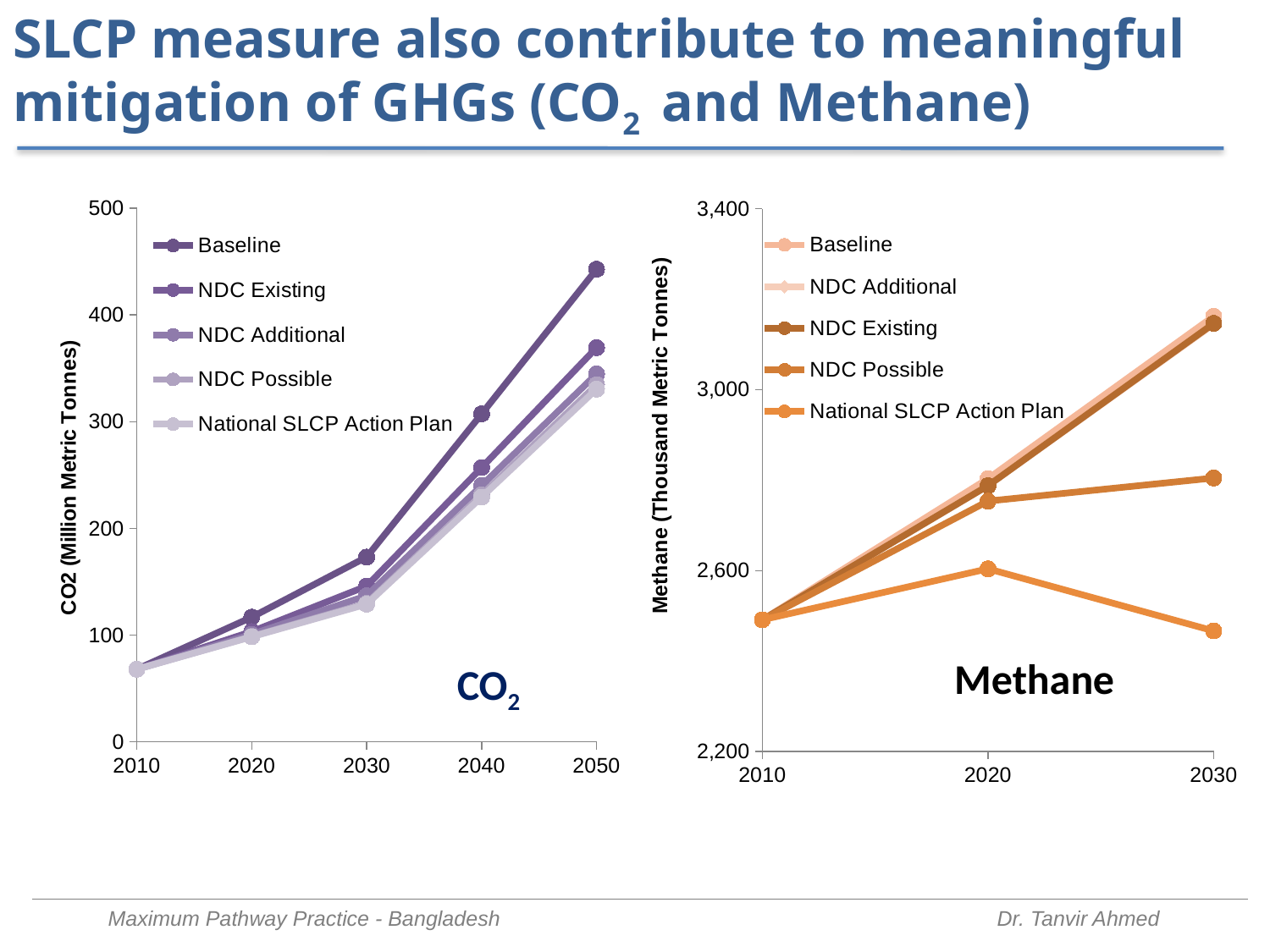
How many years are shown on the x axis of the Methane chart? 3 In the Methane chart, is the Baseline value in 2030 greater or less than 3,000? greater How many years are shown on the x axis of the CO2 chart? 5 In the Methane chart, which series has the lowest value in 2030? National SLCP Action Plan In the CO2 chart, is the Baseline value in 2050 greater or less than 400? greater What is the y-axis label of the Methane chart? Methane (Thousand Metric Tonnes) What kind of chart is the CO2 chart on the left? Line chart In the CO2 chart, which series has the highest value in 2050? Baseline In the CO2 chart, is the Baseline value in 2030 greater or less than 200? less How many series does the legend of the Methane chart list? 5 In the Methane chart, does the National SLCP Action Plan series rise or fall between 2020 and 2030? fall